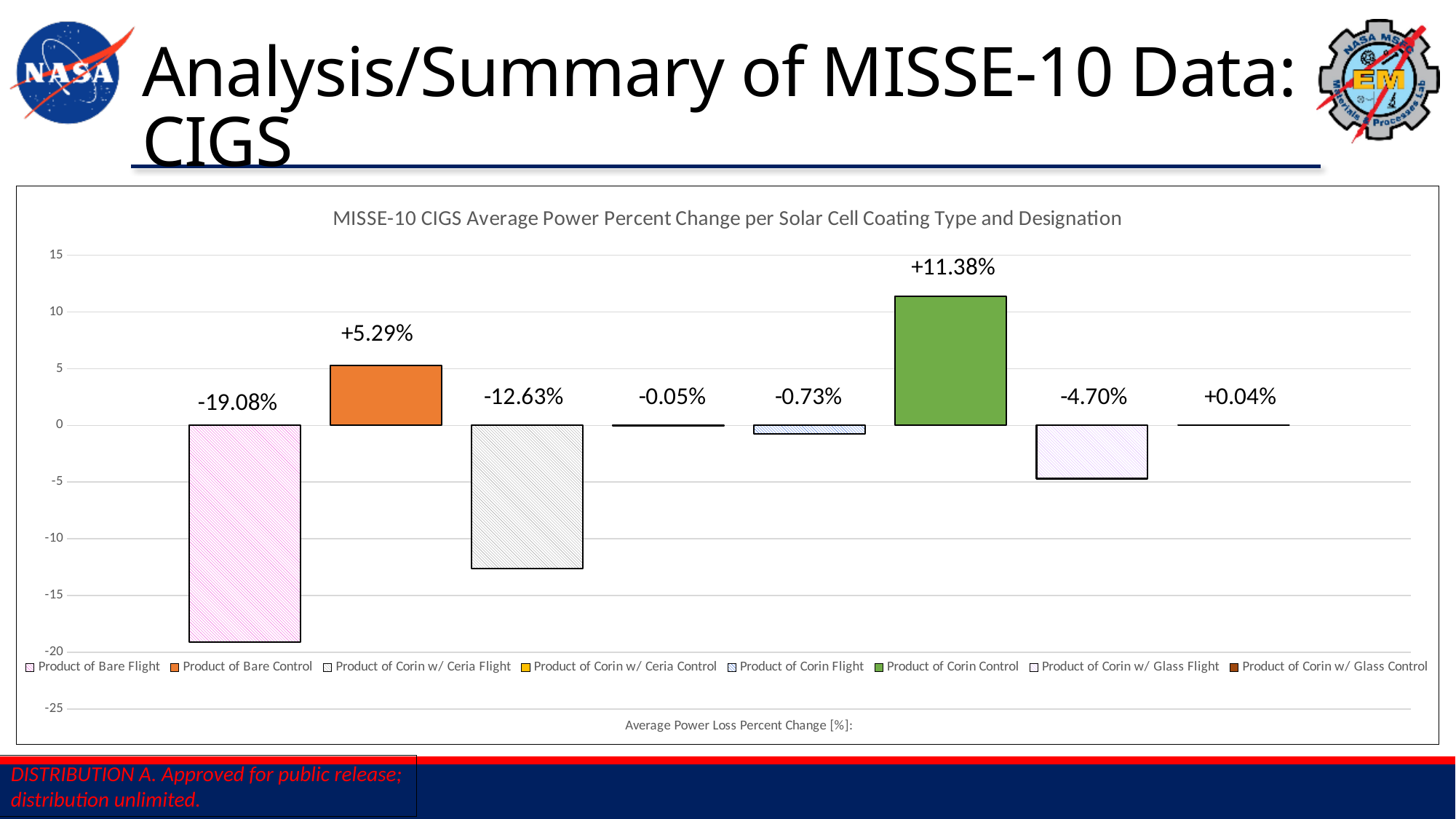
Which is larger, the value for Product of Bare Control or the value for Product of Corin w/ Glass Control? Product of Bare Control Which series has the highest value? Product of Corin Control What is the title of the chart? MISSE-10 CIGS Average Power Percent Change per Solar Cell Coating Type and Designation Is the value for Product of Corin w/ Ceria Flight greater or less than -10? less What is the value for Product of Corin Control? +11.38% What is the value for Product of Corin w/ Ceria Control? -0.05% What is the value for Product of Corin w/ Glass Flight? -4.70% What is the value for Product of Bare Flight? -19.08% How many series does the legend list? 8 Which series has the lowest value? Product of Bare Flight What is the difference between the values for Product of Corin Control and Product of Bare Control? 6.09% What kind of chart is shown? Bar chart